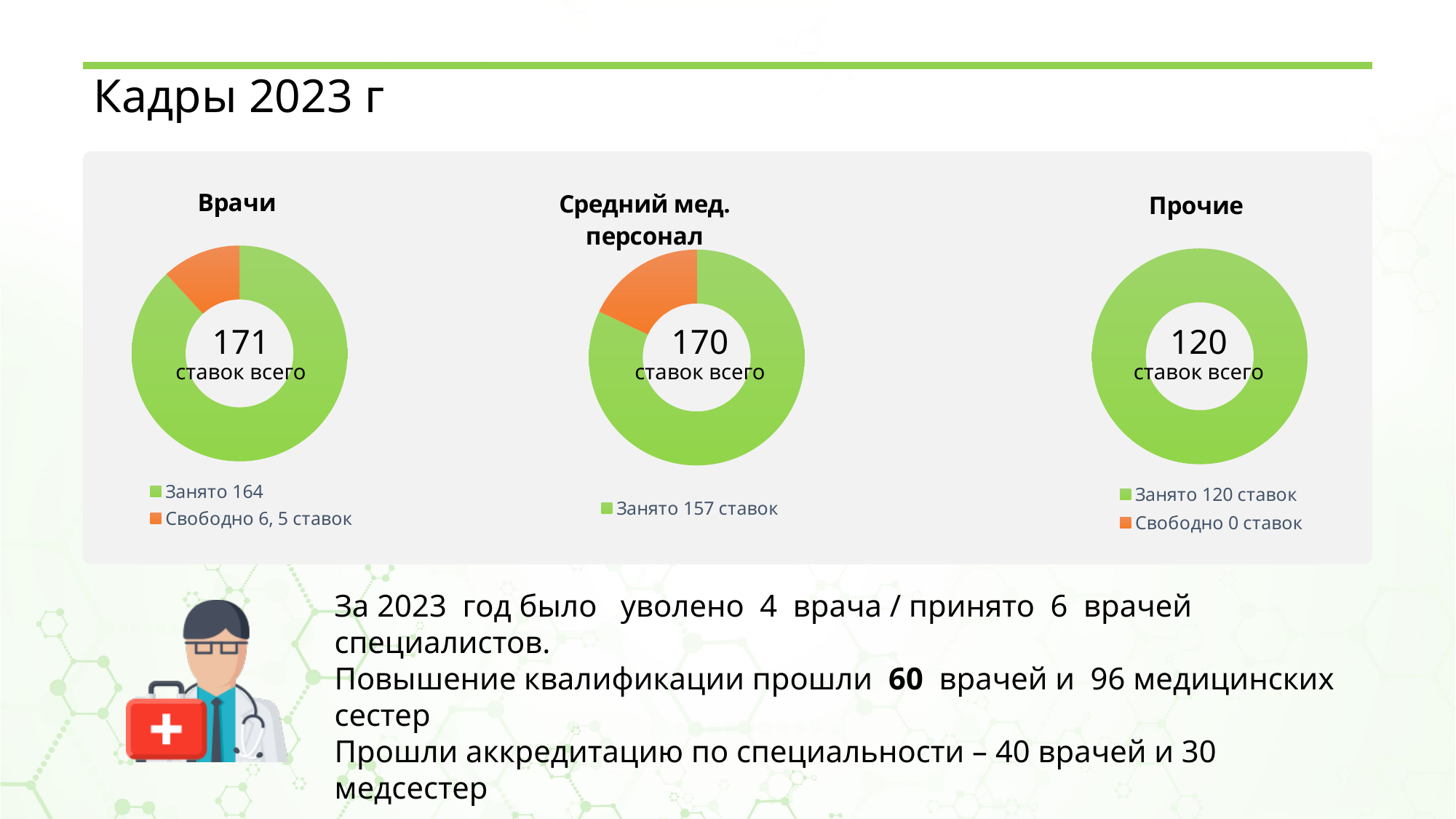
In the 'Врачи' chart, what is the value for 'Занято'? 164 What kind of chart is used for the 'Врачи' chart? pie (donut) chart How many entries does the legend of the 'Средний мед. персонал' chart list? 1 What is the difference between the total ставок in the 'Врачи' chart and the total ставок in the 'Прочие' chart? 51 Which of the three charts shows the largest total number of ставок? Врачи In the 'Средний мед. персонал' chart, what is the value for 'Занято'? 157 ставок Which of the three charts shows the smallest total number of ставок? Прочие In the 'Прочие' chart, what share of the total does 'Занято' represent? 100% In the 'Средний мед. персонал' chart, how many ставок are there in total? 170 Which is larger: 'Занято' in the 'Врачи' chart or 'Занято' in the 'Средний мед. персонал' chart? Врачи In the 'Прочие' chart, what is the value for 'Свободно'? 0 ставок In the 'Врачи' chart, how many ставок are there in total? 171